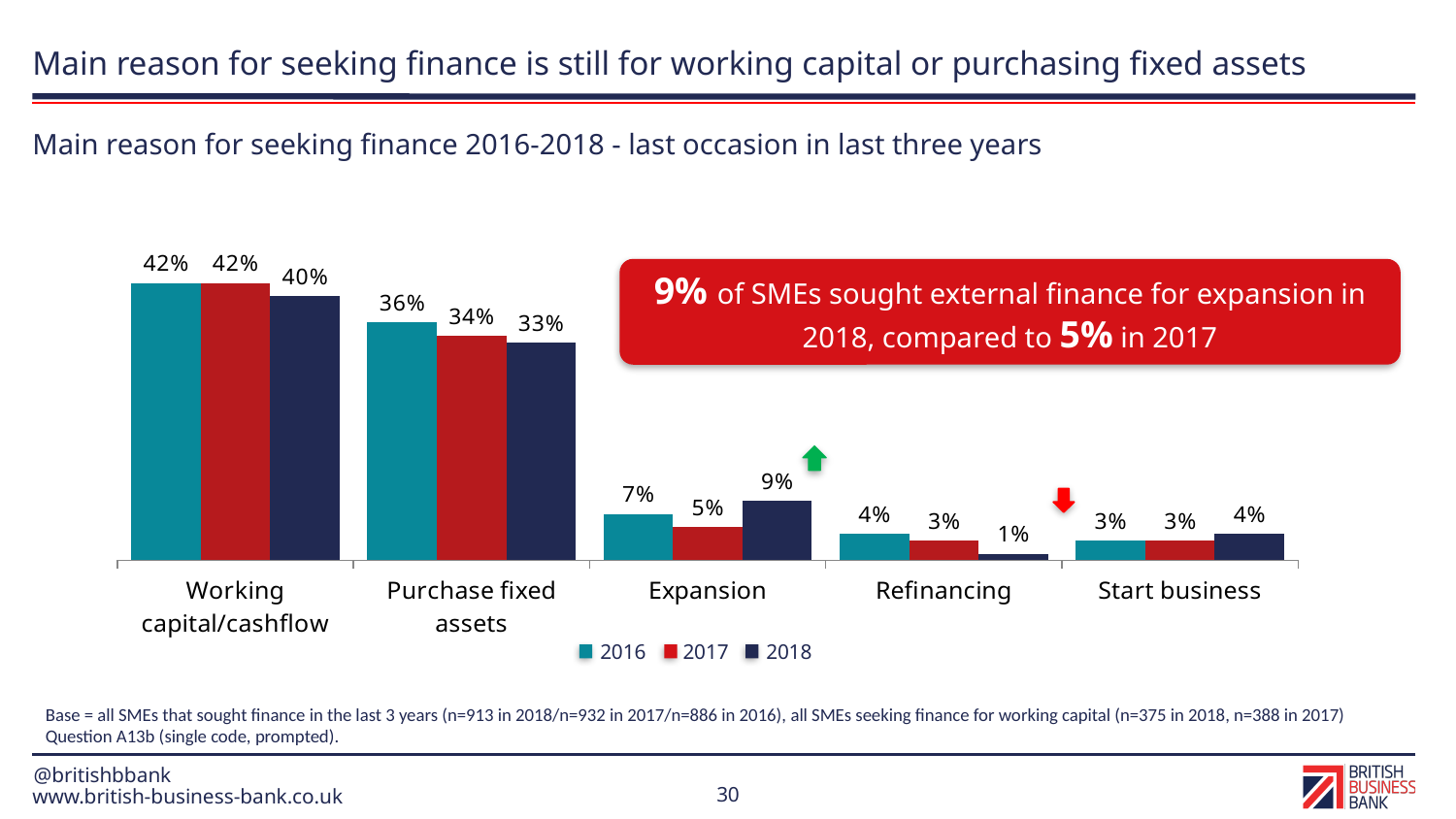
Which is larger: the 2018 value for Expansion or the 2018 value for Start business? Expansion Which category had the lowest value in 2018? Refinancing What percentage of SMEs gave working capital/cashflow as the main reason for seeking finance in 2018? 40% Which category had the highest value in 2018? Working capital/cashflow What was the value for Refinancing in 2018? 1% What was the value for Expansion in 2017? 5% What type of chart is shown on the slide? Bar chart How many series does the legend list? 3 How many categories are shown on the x axis of the chart? 5 What is the difference between the 2016 and 2018 values for Purchase fixed assets? 3% What was the value for Purchase fixed assets in 2016? 36% By how many percentage points did Expansion increase from 2017 to 2018? 4%